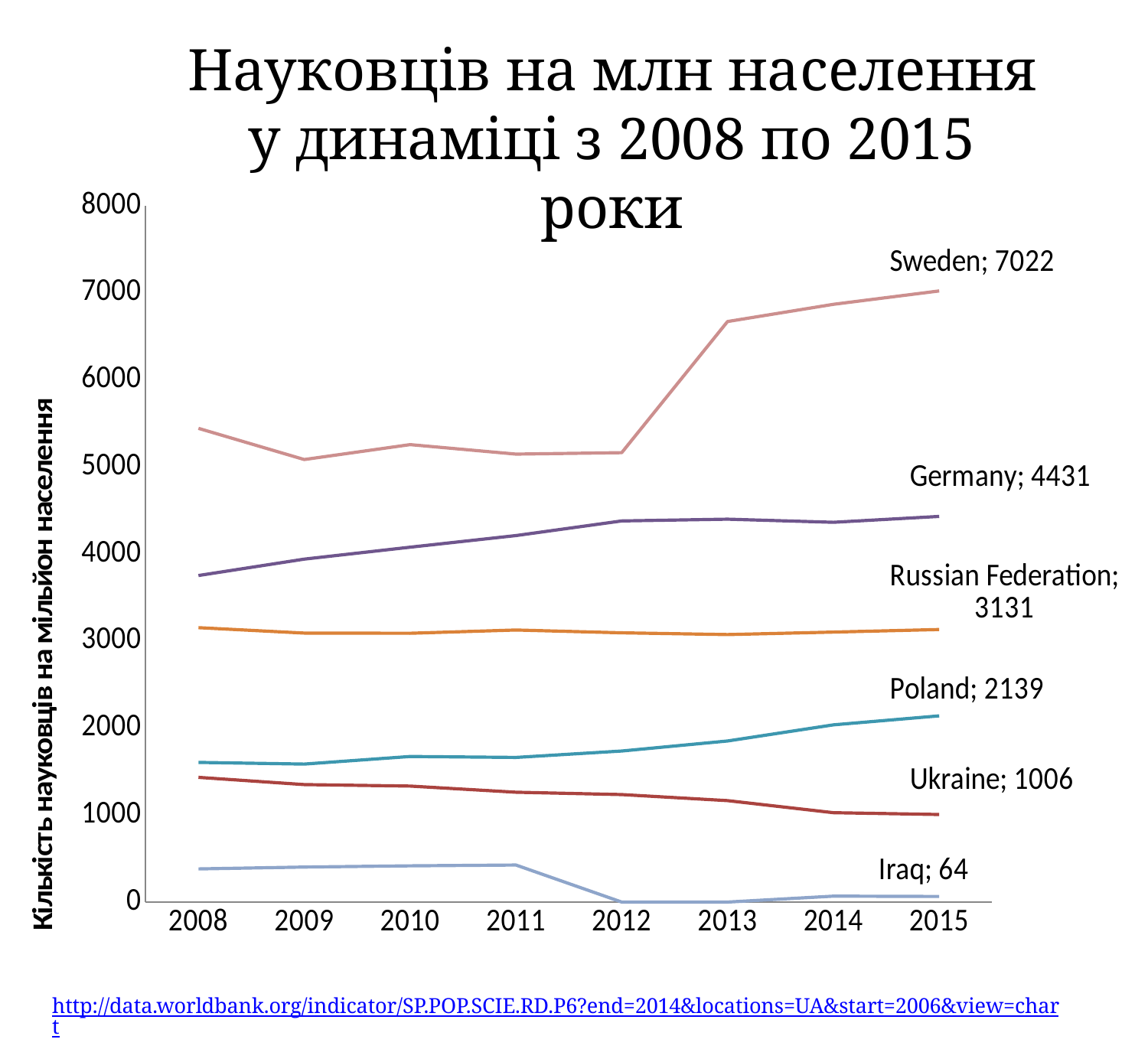
How many years are shown on the x axis? 8 What is the value for Sweden in 2015? 7022 What is the value for Iraq in 2015? 64 Which country has the highest value in 2015? Sweden What type of chart is shown on the slide? line chart Is the value for Sweden in 2008 greater or less than 5000? greater Which is larger in 2015, the value for Poland or the value for Russian Federation? Russian Federation What is the difference between the 2015 values for Sweden and Germany? 2591 Which country has the lowest value in 2015? Iraq What is the value for Ukraine in 2015? 1006 Does the value for Ukraine rise or fall from 2008 to 2015? fall What is the value for Germany in 2015? 4431